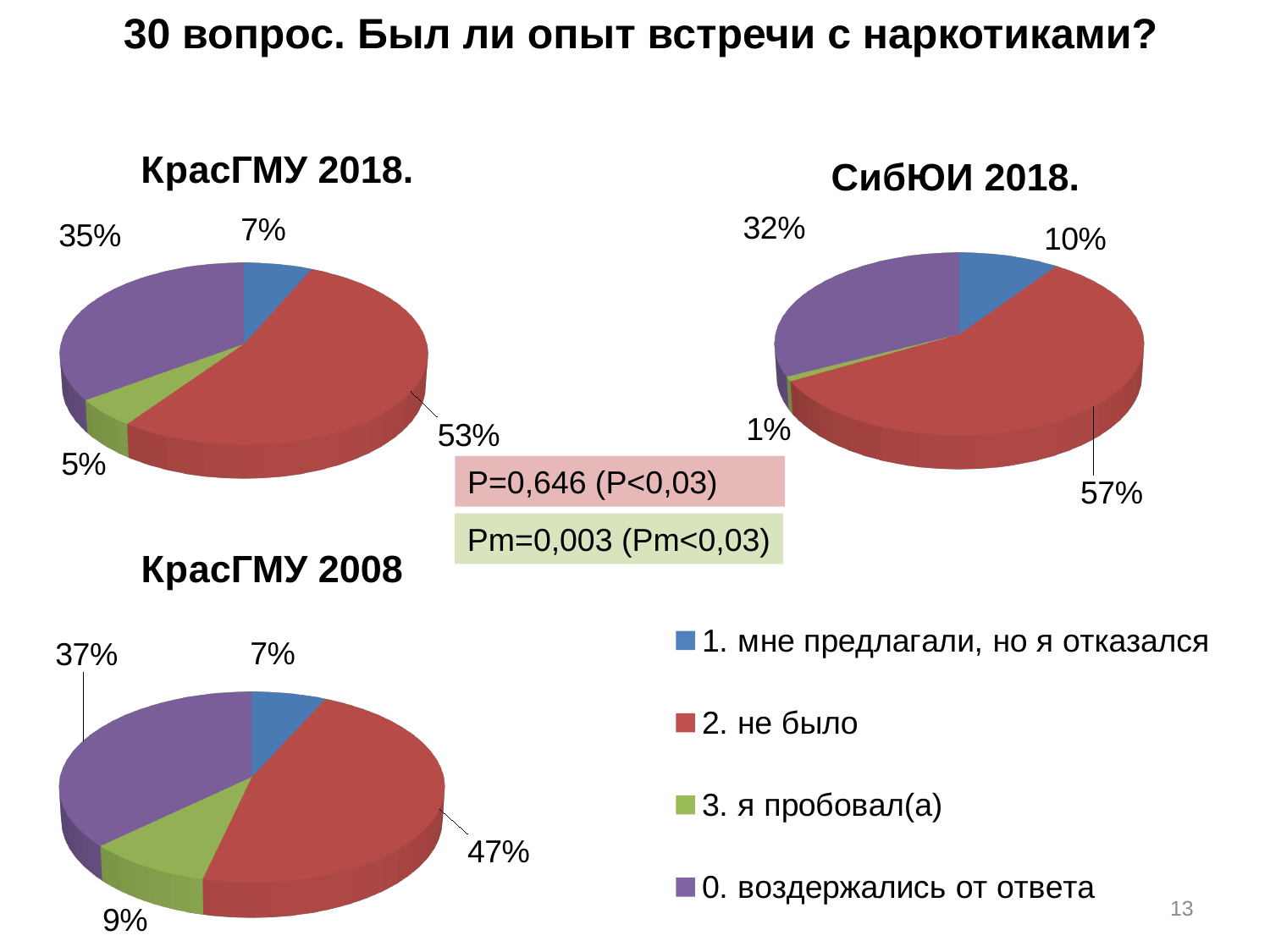
Which colour represents '0. воздержались от ответа' in the legend? Purple What is the difference between the '2. не было' share in the СибЮИ 2018 chart and in the КрасГМУ 2008 chart? 10% What type of chart is used for КрасГМУ 2008? Pie chart In the СибЮИ 2018 chart, what share is labelled for the slice '1. мне предлагали, но я отказался'? 10% Which is larger: the '3. я пробовал(а)' share in the КрасГМУ 2008 chart or in the КрасГМУ 2018 chart? КрасГМУ 2008 In the КрасГМУ 2018 chart, what share is labelled for the slice '2. не было'? 53% In the КрасГМУ 2018 chart, which category has the largest slice? 2. не было In the СибЮИ 2018 chart, which category has the smallest slice? 3. я пробовал(а) In the КрасГМУ 2008 chart, which category has the smallest slice? 1. мне предлагали, но я отказался In the СибЮИ 2018 chart, what share is labelled for the slice '3. я пробовал(а)'? 1% How many slices does the КрасГМУ 2018 pie chart have? 4 In the КрасГМУ 2008 chart, what share is labelled for the slice '0. воздержались от ответа'? 37%